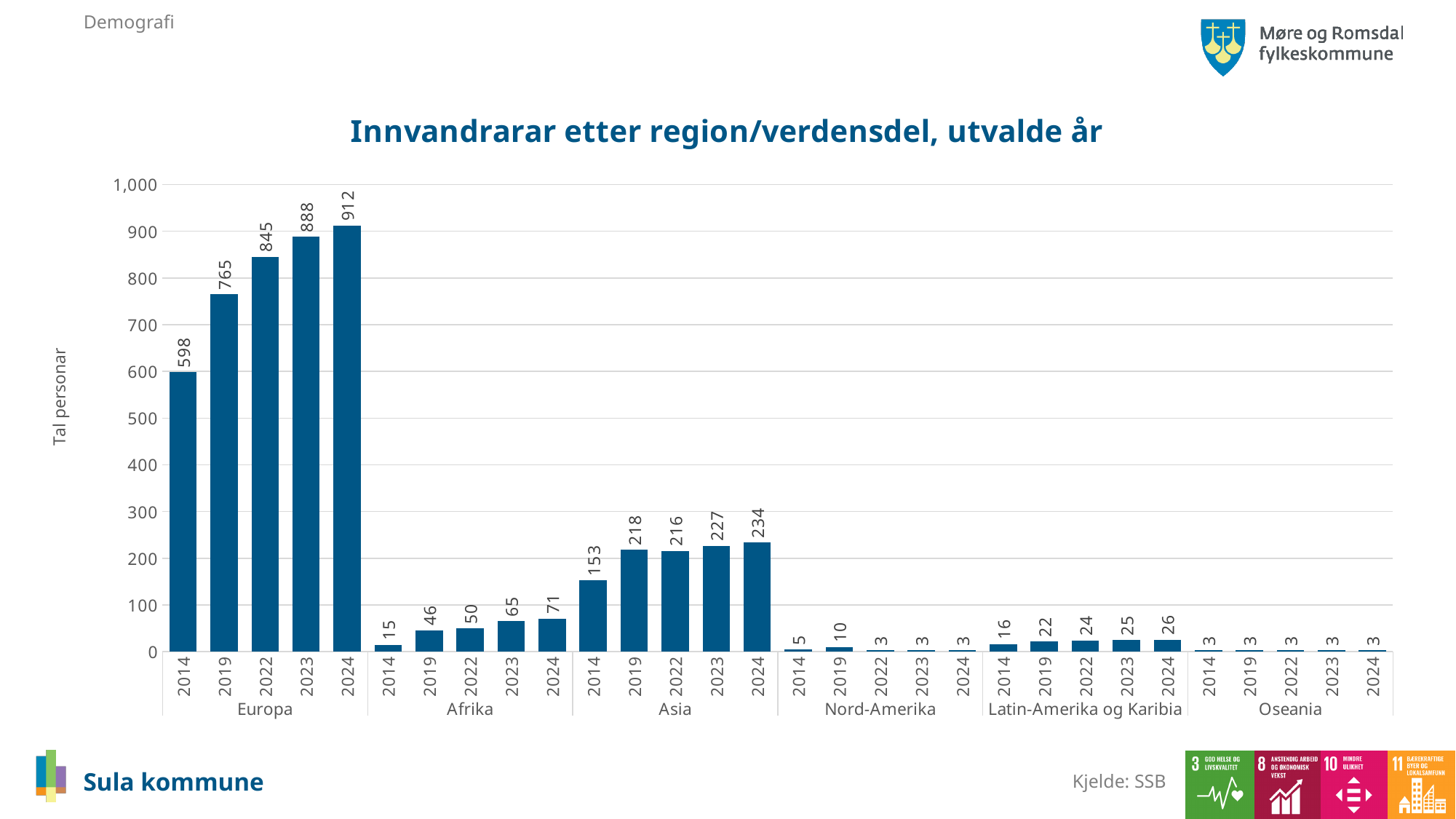
Which region has the lowest value in 2019? Oseania Which region has the highest value in 2024? Europa What is the value for Asia in 2014? 153 Which is larger: Asia in 2019 or Asia in 2022? Asia in 2019 What is the difference between the Europa values for 2024 and 2014? 314 Do the values for Afrika rise or fall from 2014 to 2024? Rise What is the value for Afrika in 2022? 50 Is the value for Europa in 2019 greater or less than 700? greater What is the value for Latin-Amerika og Karibia in 2023? 25 What is the value for Europa in 2024? 912 How many regions are shown on the x axis? 6 What kind of chart is this? Bar chart